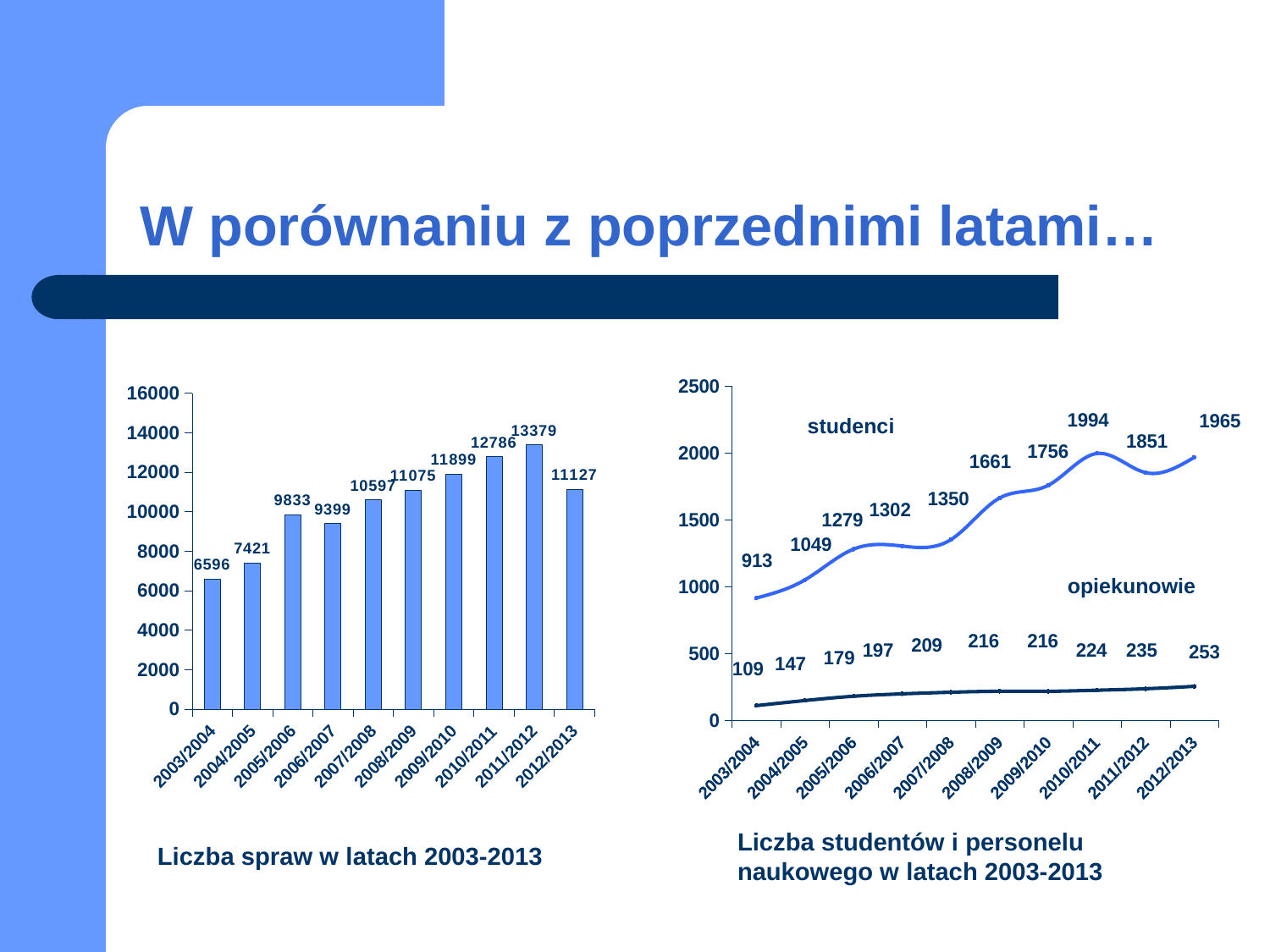
What kind of chart is the left chart (Liczba spraw w latach 2003-2013)? bar chart In the left chart (Liczba spraw w latach 2003-2013), which year has the lowest value? 2003/2004 In the left chart (Liczba spraw w latach 2003-2013), which year has the highest value? 2011/2012 In the left chart (Liczba spraw w latach 2003-2013), how many years are shown on the x axis? 10 In the right chart (Liczba studentów i personelu naukowego), what is the value for opiekunowie in 2012/2013? 253 In the left chart (Liczba spraw w latach 2003-2013), what is the difference between the values for 2011/2012 and 2012/2013? 2252 In the right chart (Liczba studentów i personelu naukowego), what is the value for studenci in 2010/2011? 1994 In the left chart (Liczba spraw w latach 2003-2013), which is larger: the value for 2005/2006 or 2006/2007? 2005/2006 In the right chart (Liczba studentów i personelu naukowego), how many series are plotted? 2 In the left chart (Liczba spraw w latach 2003-2013), what is the value for 2008/2009? 11075 In the right chart (Liczba studentów i personelu naukowego), do the values for opiekunowie generally rise or fall from 2003/2004 to 2012/2013? rise In the right chart (Liczba studentów i personelu naukowego), what is the difference between studenci and opiekunowie in 2003/2004? 804